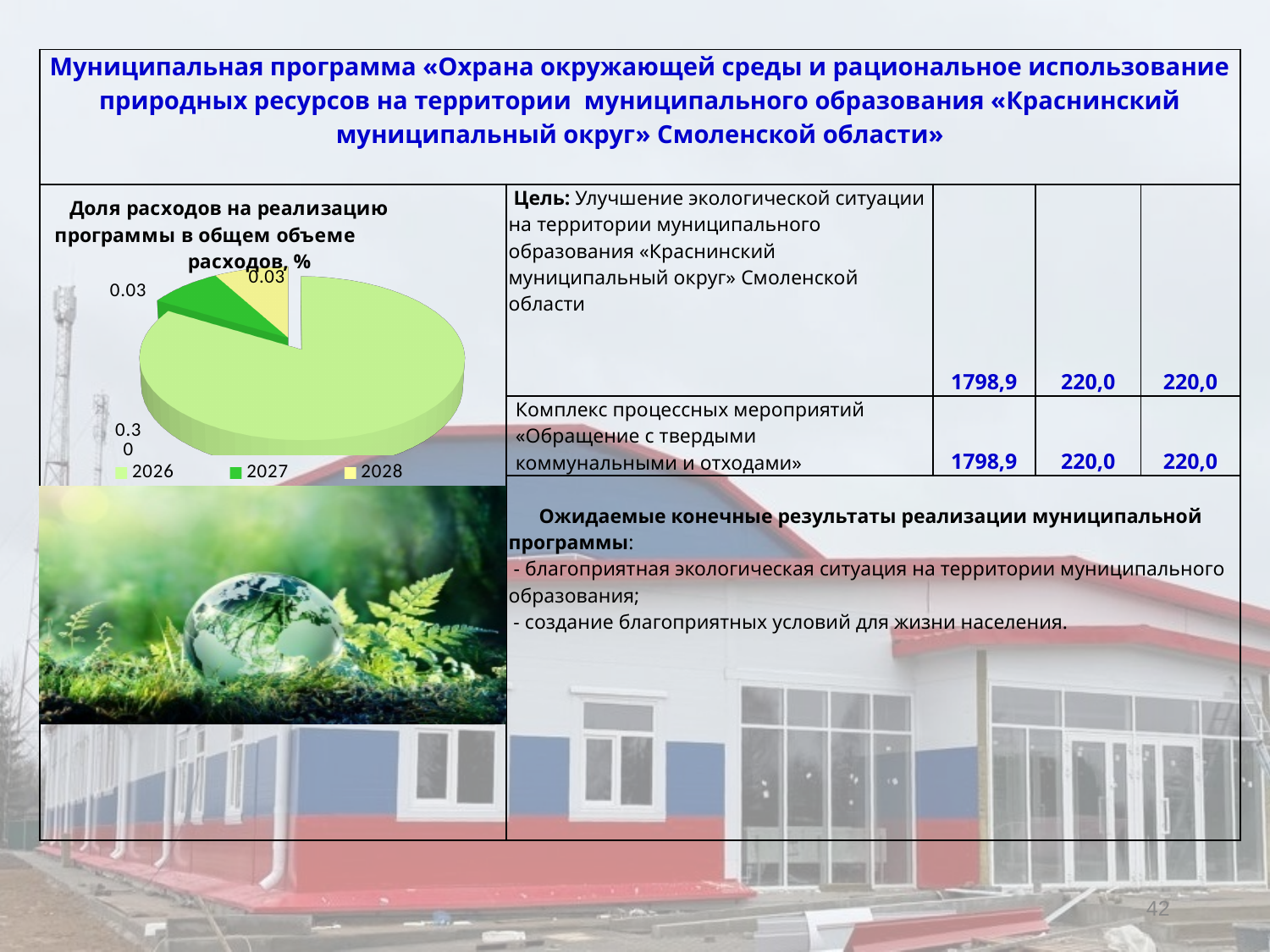
What is the title of the pie chart? Доля расходов на реализацию программы в общем объеме расходов, % How many categories does the legend of the pie chart list? 3 Which slice is larger in the pie chart, 2026 or 2027? 2026 What value is labelled for 2028 in the pie chart? 0.03 What kind of chart is shown on the slide? pie chart Which year has the largest slice in the pie chart? 2026 Which slice is larger in the pie chart, 2026 or 2028? 2026 Which years are listed in the legend of the pie chart? 2026, 2027, 2028 What value is labelled for 2027 in the pie chart? 0.03